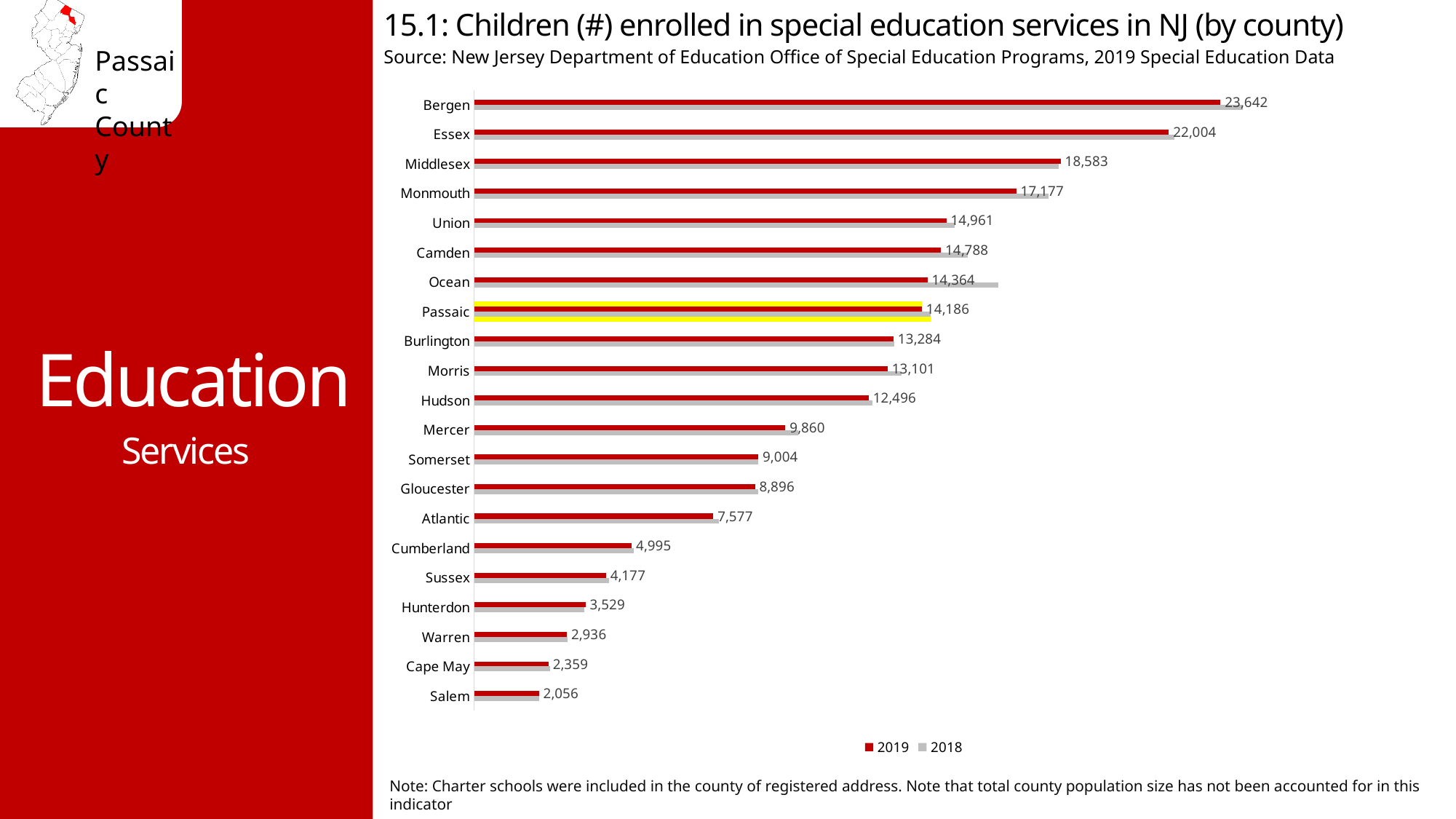
Which county has the lowest number of children enrolled in special education services in 2019? Salem How many series does the legend list? 2 How many children were enrolled in special education services in Bergen County in 2019? 23,642 What kind of chart is shown on the slide? Bar chart What is the 2019 value shown for Salem County? 2,056 Which county had more children enrolled in 2019, Union or Camden? Union What is the difference between the 2019 values for Passaic and Burlington? 902 What is the 2019 value shown for Passaic County? 14,186 Which county has the highest number of children enrolled in special education services in 2019? Bergen How many counties are listed on the chart? 21 What is the difference between the 2019 values for Bergen and Essex? 1,638 Which county's bars are highlighted in yellow on the chart? Passaic